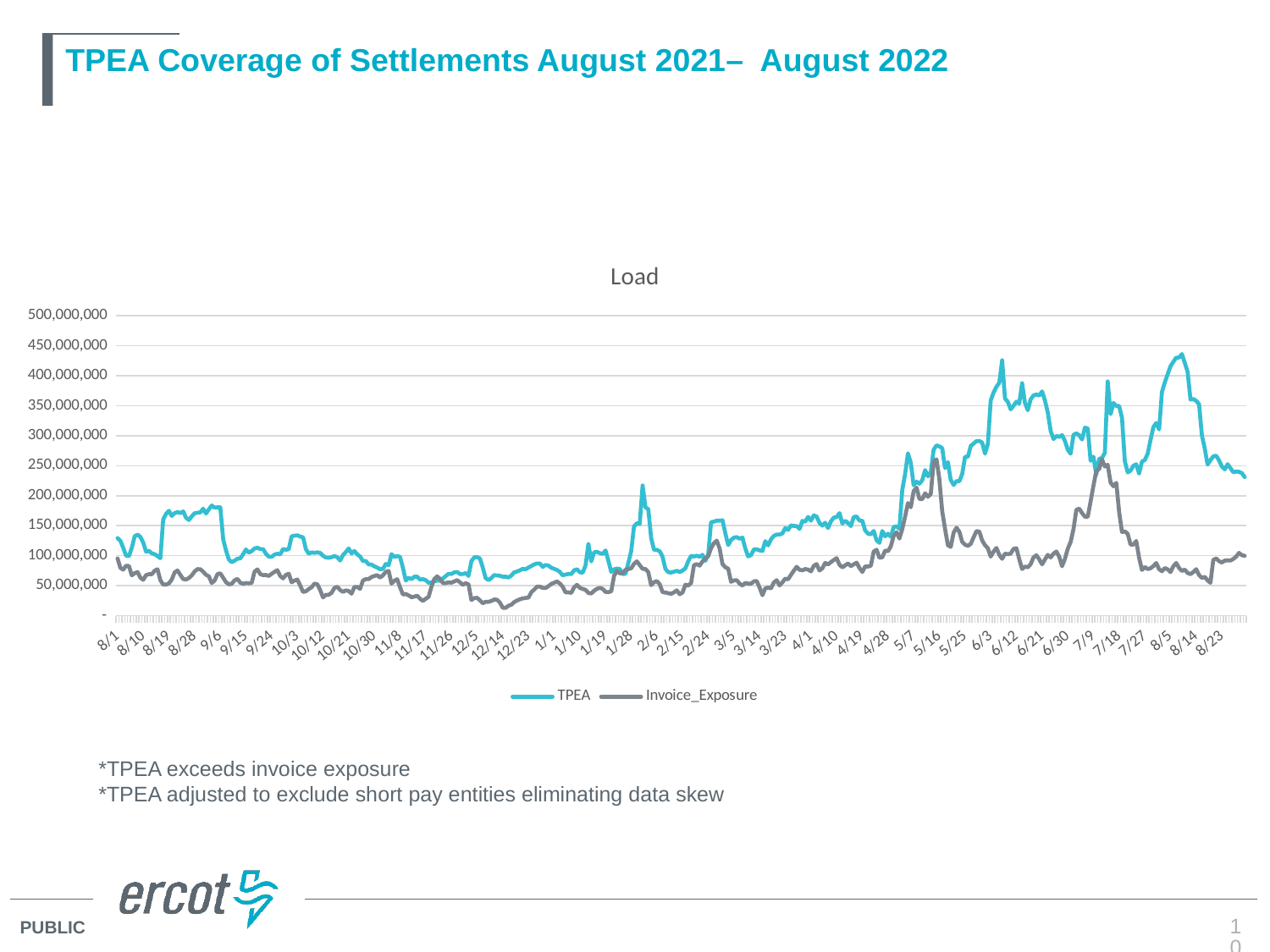
How many series does the legend of the chart list? 2 What are the two series named in the chart legend? TPEA and Invoice_Exposure Is the peak value of the TPEA line around 8/5 greater or less than 400,000,000? greater Around 8/5, which series has the larger value, TPEA or Invoice_Exposure? TPEA What is the title shown above the chart's plot area? Load Is the value of the Invoice_Exposure line around 12/14 greater or less than 50,000,000? less What kind of chart is shown on the slide? line chart Is the value of the TPEA line at 8/1 greater or less than 100,000,000? greater Does the Invoice_Exposure line rise or fall between 7/9 and 7/27? fall Does the TPEA line rise or fall between 4/28 and 6/3? rise Which series reaches the highest value anywhere on the chart? TPEA